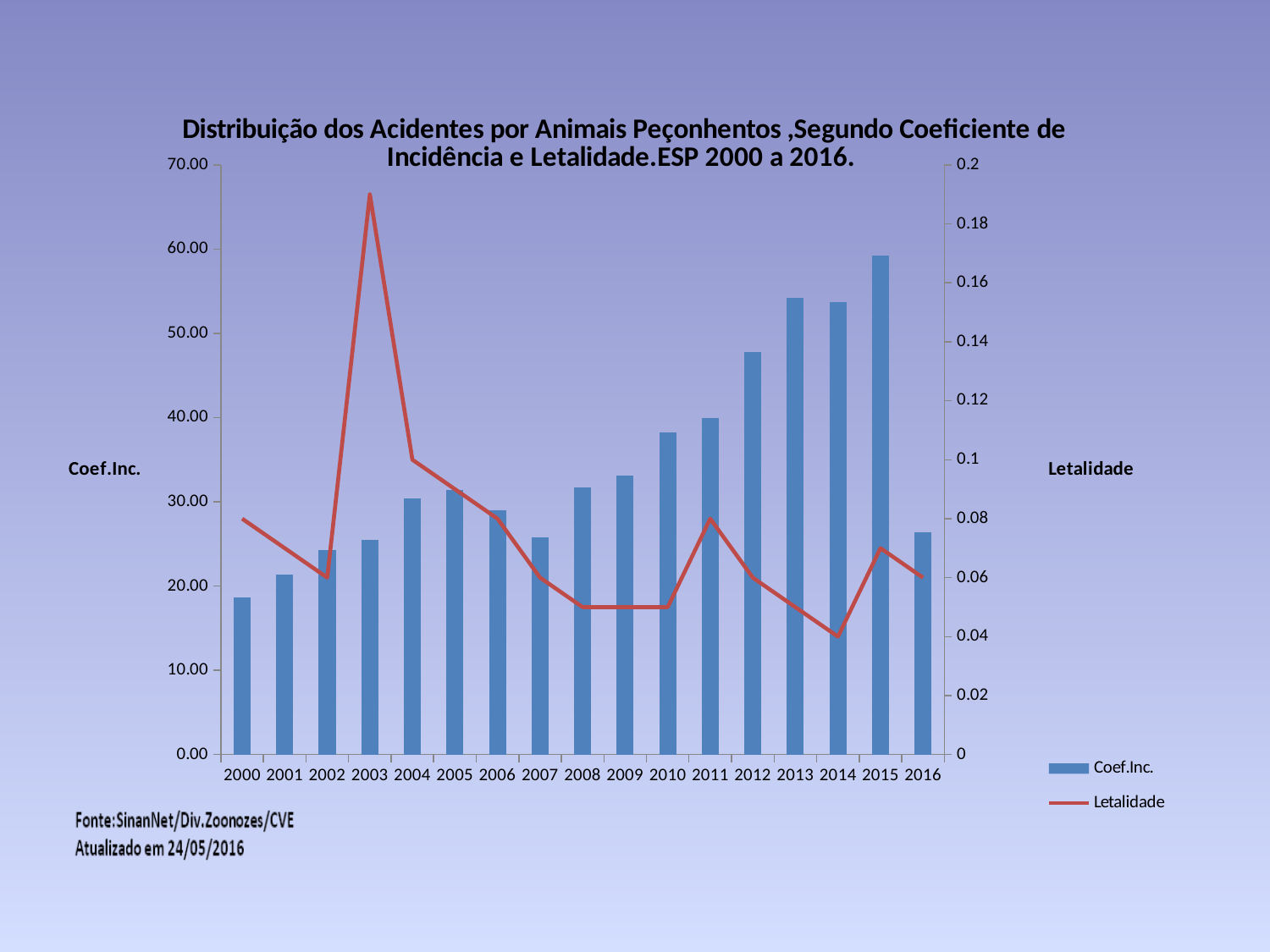
Which year has the highest Coef.Inc. bar? 2015 Is the Coef.Inc. value for 2000 greater or less than 20.00? less Is the Coef.Inc. value for 2015 greater or less than 50.00? greater Which series is drawn as a line in the chart? Letalidade How many years are shown on the x axis of the chart? 17 Which year has the lowest Coef.Inc. bar? 2000 In which year does the Letalidade line reach its highest point? 2003 In which year does the Letalidade line reach its lowest point? 2014 Is the Letalidade value for 2003 greater or less than 0.16? greater How many series does the legend list? 2 Which year has the larger Coef.Inc. bar, 2012 or 2013? 2013 What kind of chart is shown on the slide? A combined bar and line chart